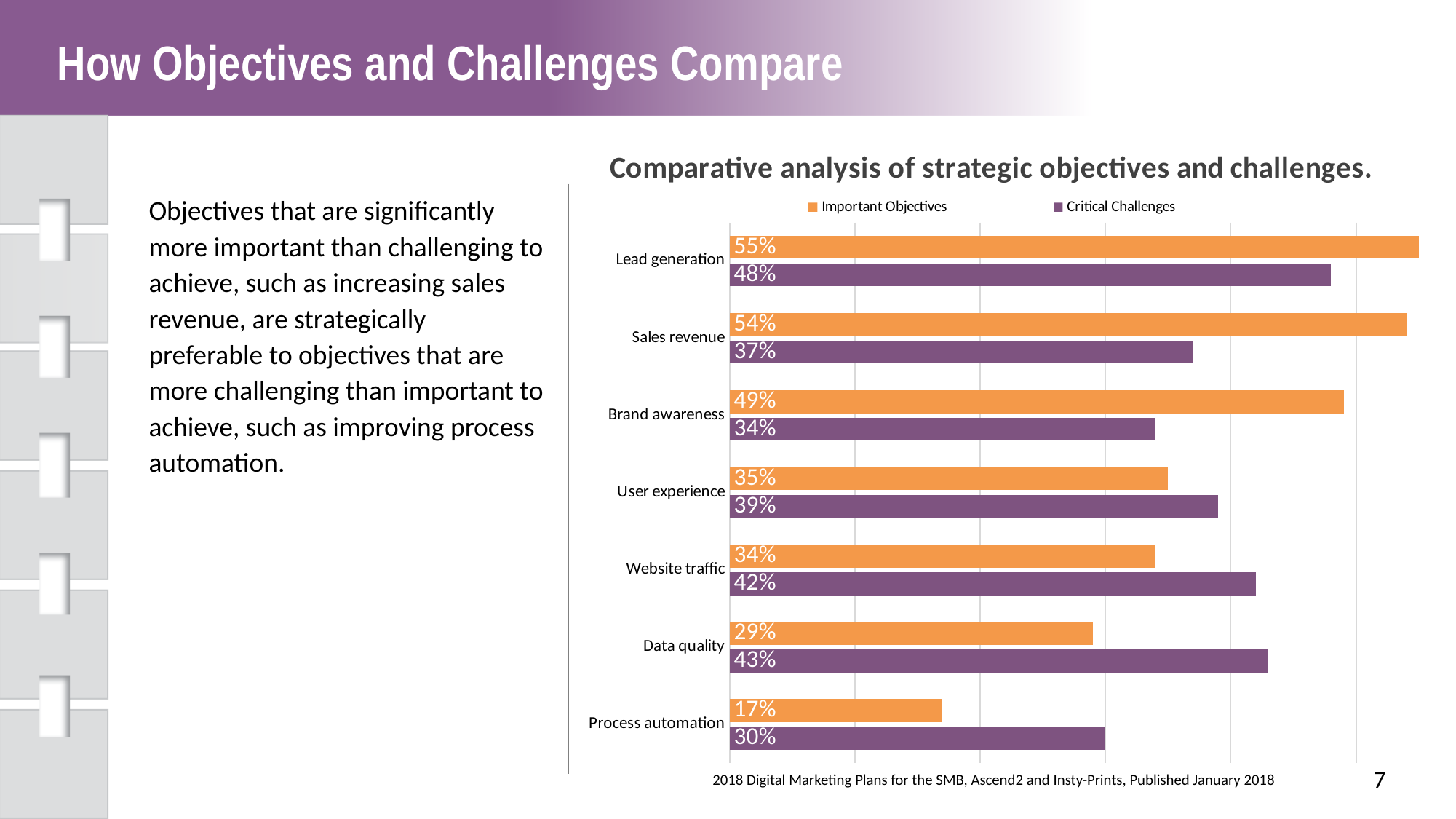
What is the Critical Challenges value for Data quality? 43% What is the Important Objectives value for Lead generation? 55% How many series does the legend list? 2 Which is larger for Website traffic: Important Objectives or Critical Challenges? Critical Challenges What is the Important Objectives value for Process automation? 17% How many categories are shown on the chart? 7 Which category has the highest Important Objectives value? Lead generation Which colour represents the Critical Challenges series? Purple What kind of chart is shown on the slide? Bar chart What is the title of the chart? Comparative analysis of strategic objectives and challenges. Which category has the lowest Critical Challenges value? Process automation What is the difference between the Important Objectives and Critical Challenges values for Sales revenue? 17%